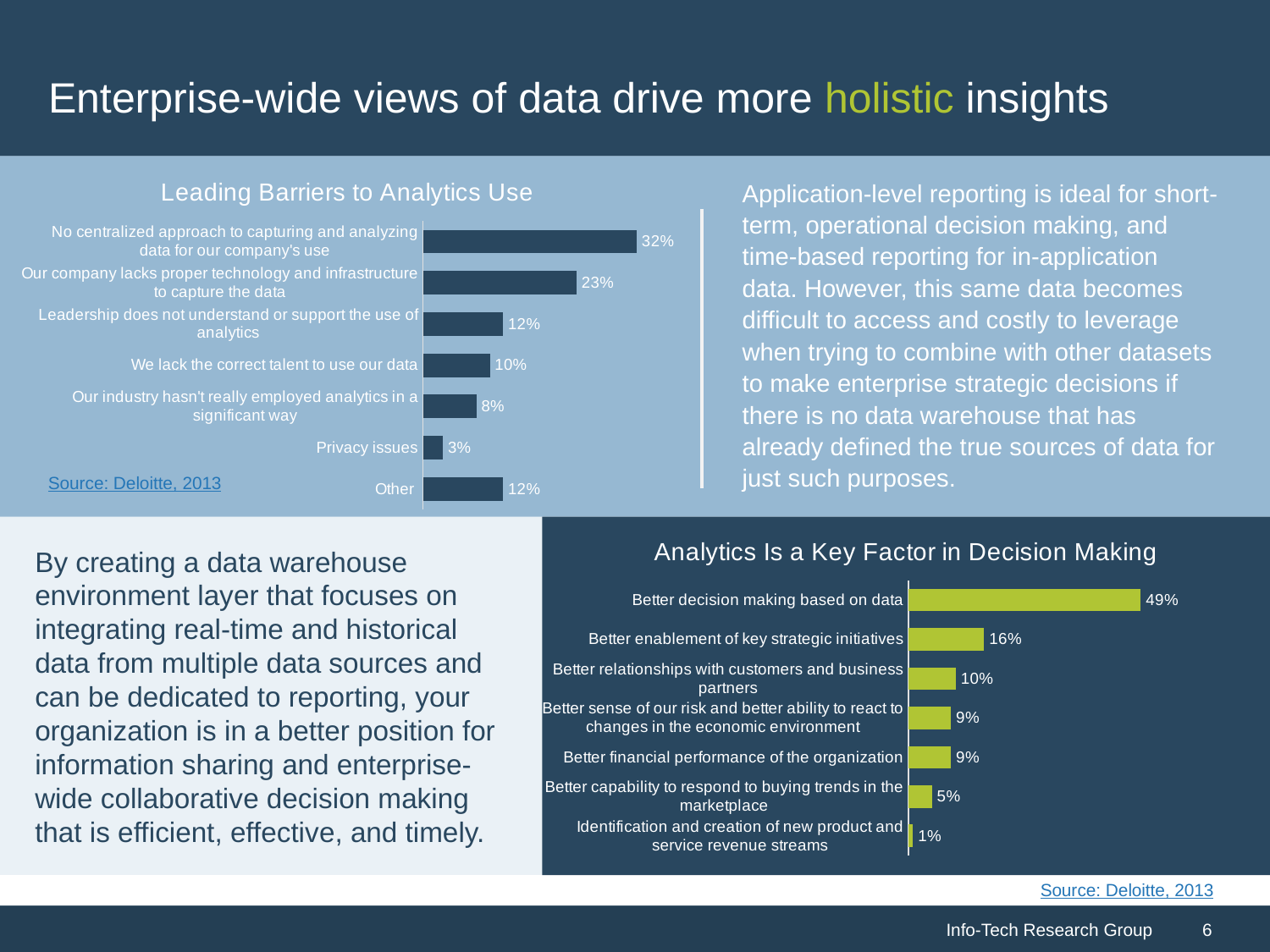
In the 'Analytics Is a Key Factor in Decision Making' chart, what is the value for 'Identification and creation of new product and service revenue streams'? 1% In the 'Analytics Is a Key Factor in Decision Making' chart, what percentage is shown for 'Better decision making based on data'? 49% In the 'Leading Barriers to Analytics Use' chart, what is the difference between 'Our company lacks proper technology and infrastructure to capture the data' and 'We lack the correct talent to use our data'? 13% In the 'Analytics Is a Key Factor in Decision Making' chart, which category has the highest value? Better decision making based on data In the 'Leading Barriers to Analytics Use' chart, what percentage is shown for 'No centralized approach to capturing and analyzing data for our company's use'? 32% In the 'Analytics Is a Key Factor in Decision Making' chart, what is the difference between 'Better decision making based on data' and 'Better enablement of key strategic initiatives'? 33% What source is cited for the 'Leading Barriers to Analytics Use' chart? Deloitte, 2013 In the 'Leading Barriers to Analytics Use' chart, which is larger: 'Leadership does not understand or support the use of analytics' or 'Our industry hasn't really employed analytics in a significant way'? Leadership does not understand or support the use of analytics In the 'Leading Barriers to Analytics Use' chart, how many barriers are listed? 7 In the 'Leading Barriers to Analytics Use' chart, what is the value for 'Privacy issues'? 3% In the 'Leading Barriers to Analytics Use' chart, which barrier has the lowest percentage? Privacy issues What type of chart is 'Analytics Is a Key Factor in Decision Making'? Bar chart